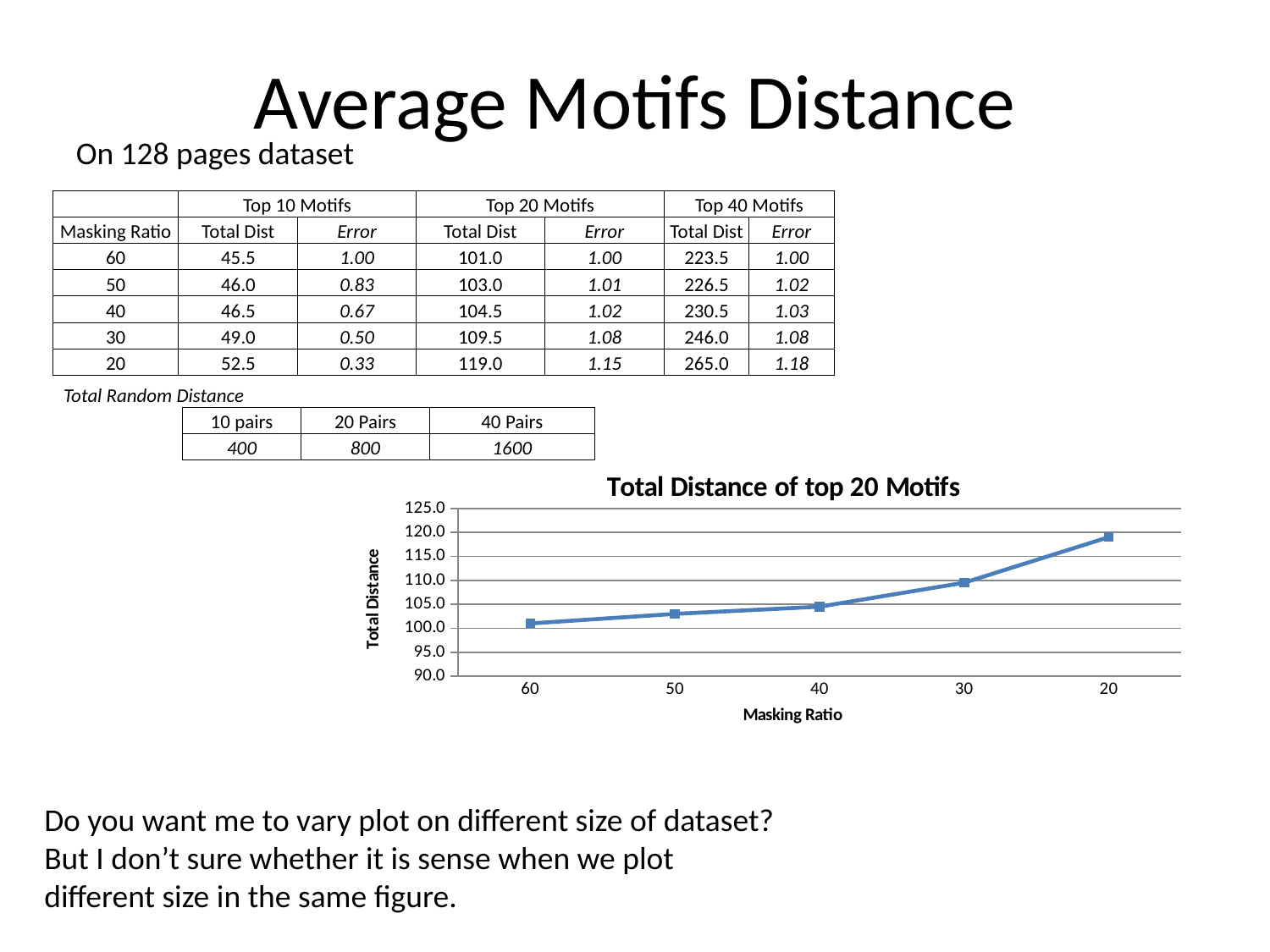
Is the total distance at masking ratio 30 greater or less than 105.0? greater Is the total distance at masking ratio 60 greater or less than 105.0? less Does the total distance rise or fall moving along the x axis from masking ratio 60 to 20? rise What kind of chart is shown on the slide? line chart What is the title of the chart? Total Distance of top 20 Motifs Which masking ratio has the lowest total distance on the chart? 60 How many masking ratio points are plotted on the chart? 5 What is the label of the x axis of the chart? Masking Ratio Is the total distance at masking ratio 20 greater or less than 115.0? greater According to the table, what is the total distance of the top 20 motifs at masking ratio 20? 119.0 Which masking ratio has the highest total distance on the chart? 20 Which is larger on the chart, the total distance at masking ratio 30 or at masking ratio 40? 30